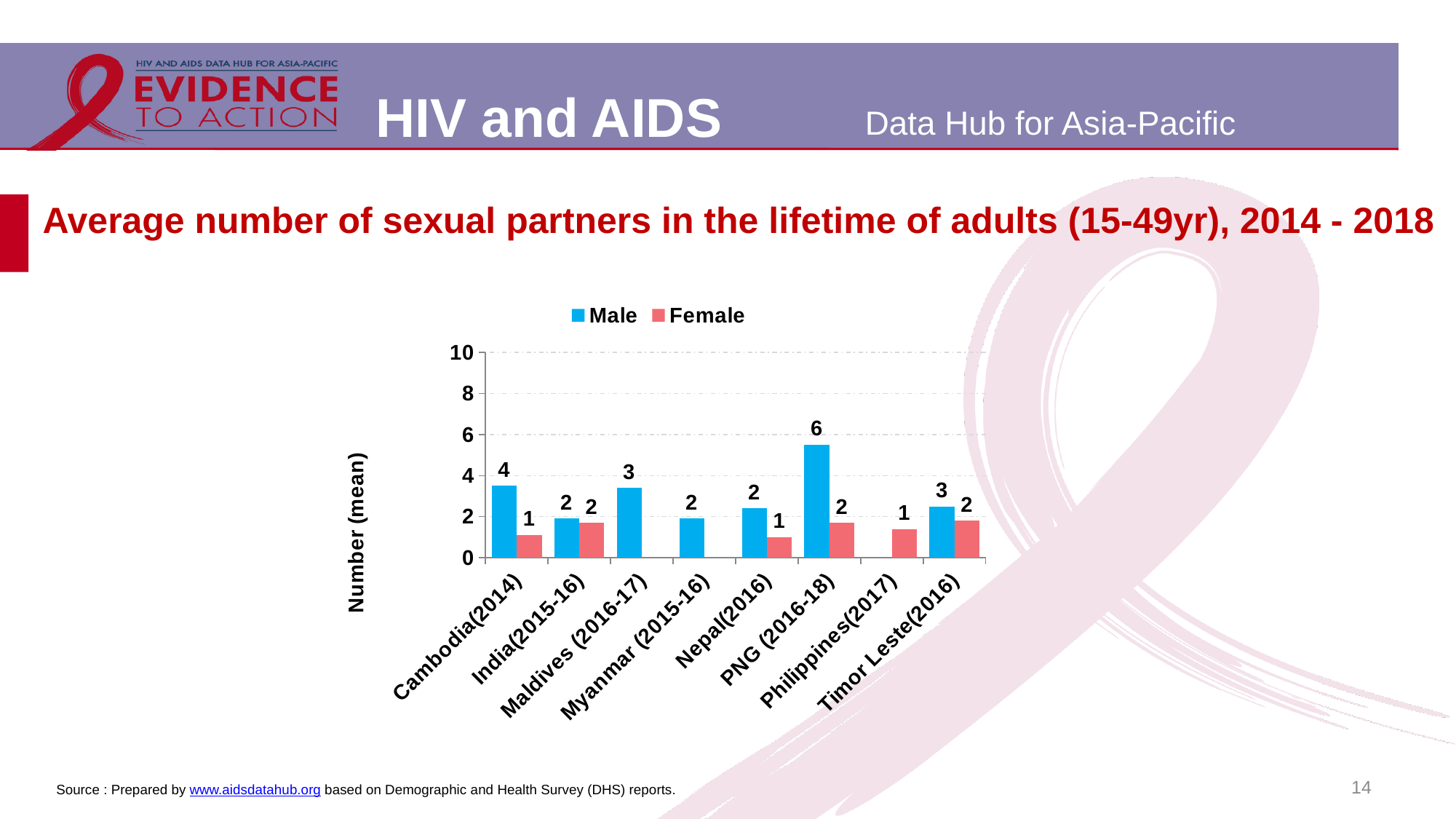
What is the Male value for PNG (2016-18)? 6 What kind of chart is shown on the slide? bar chart What is the Female value for Timor Leste(2016)? 2 What is the Female value for Cambodia(2014)? 1 How many countries are shown on the x axis? 8 Which is larger for Cambodia(2014), the Male value or the Female value? Male How many series does the legend list? 2 What is the difference between the Male and Female values for PNG (2016-18)? 4 What is the label of the y axis? Number (mean) What is the Male value for Maldives (2016-17)? 3 Is the Male value for PNG (2016-18) greater or less than 4? greater Which country has the highest Male value? PNG (2016-18)